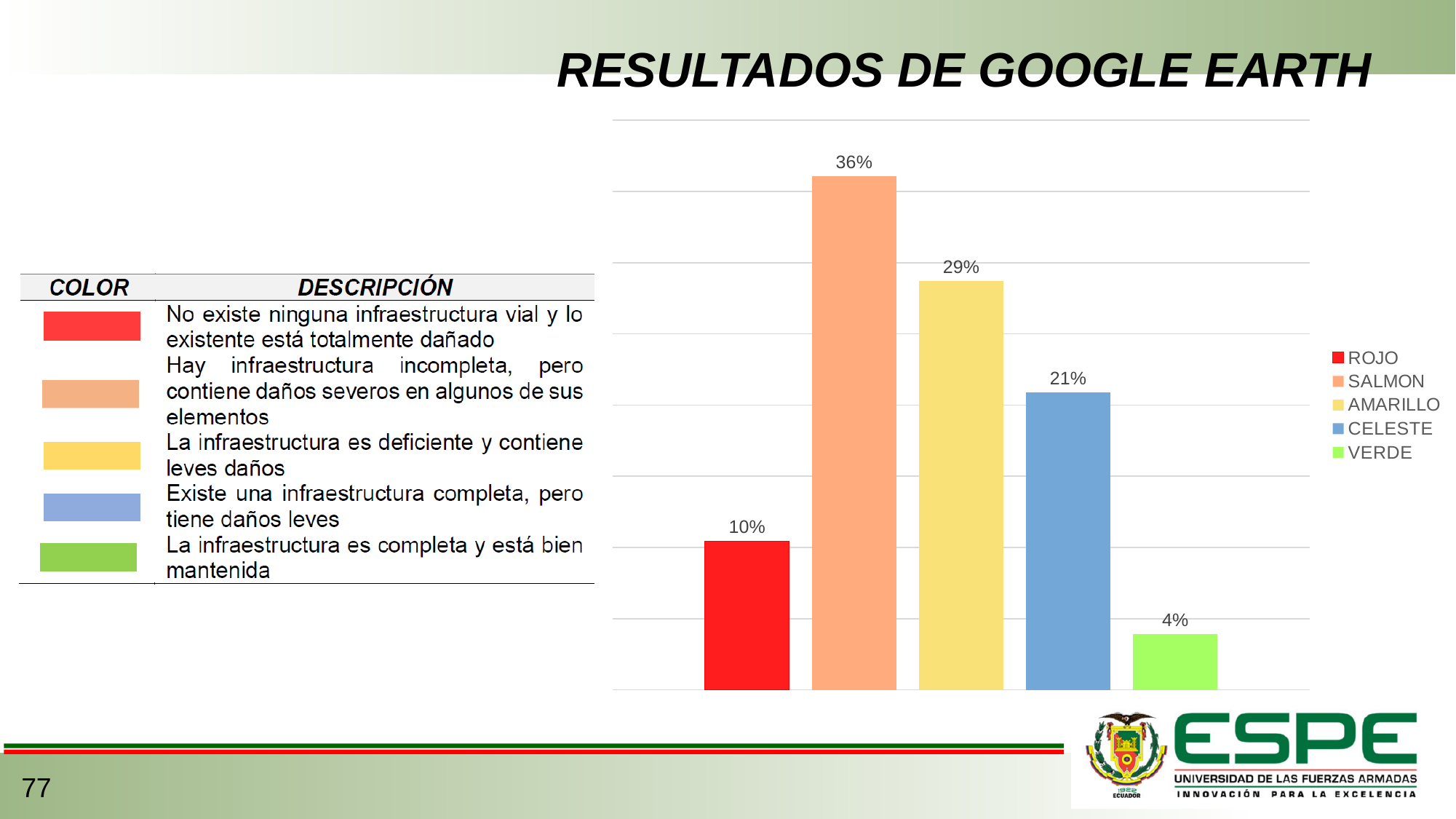
Which is larger, the value for ROJO or the value for CELESTE? CELESTE Which category has the highest value? SALMON What colour is the bar for AMARILLO? Yellow What is the value for CELESTE? 21% Which category has the lowest value? VERDE What kind of chart is shown on the slide? Bar chart What is the value for VERDE? 4% What is the value for ROJO? 10% What is the value for SALMON? 36% How many bars are plotted in the chart? 5 How many series does the legend list? 5 What is the difference between the values for SALMON and AMARILLO? 7%